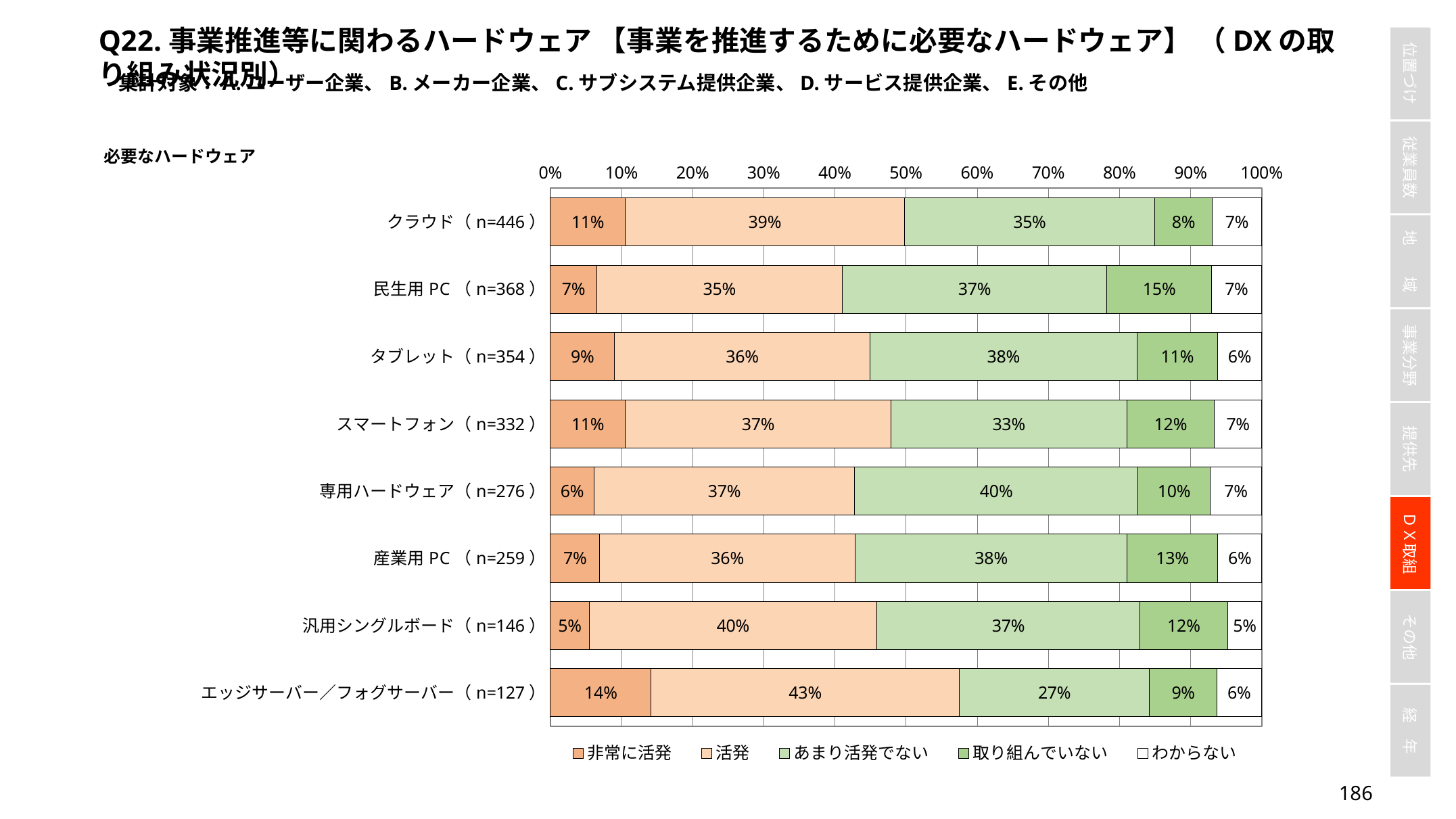
How many series does the legend list? 5 Which category has the highest 非常に活発 value? エッジサーバー／フォグサーバー (n=127) How many hardware categories are plotted in the chart? 8 What is the combined share of 非常に活発 and 活発 for タブレット (n=354)? 45% What is the 非常に活発 value for エッジサーバー／フォグサーバー (n=127)? 14% What is the あまり活発でない value for 専用ハードウェア (n=276)? 40% Which category has the lowest 非常に活発 value? 汎用シングルボード (n=146) What is the 取り組んでいない value for 民生用PC (n=368)? 15% What is the 活発 value for クラウド (n=446)? 39% What type of chart is shown on the slide? Stacked bar chart Which is larger: the 取り組んでいない value for 産業用PC (n=259) or for クラウド (n=446)? 産業用PC (n=259) What is the difference between the 活発 values for エッジサーバー／フォグサーバー (n=127) and 民生用PC (n=368)? 8%